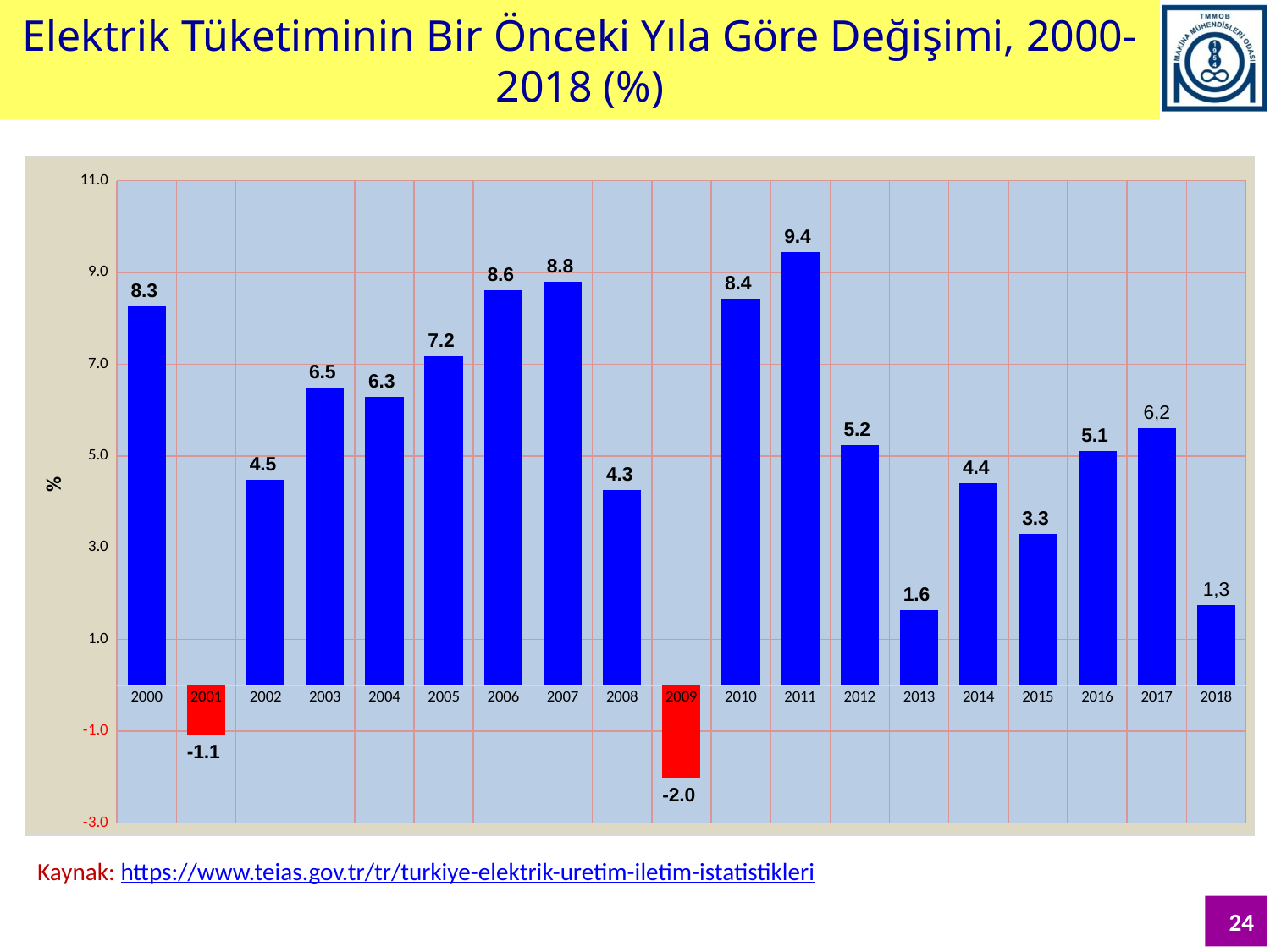
What is the value for 2017? 6,2 What is the value for 2009? -2.0 Which year has the highest value? 2011 What is the difference between the values for 2007 and 2006? 0.2 What is the difference between the values for 2011 and 2010? 1.0 Do the values rise or fall from 2011 to 2013? Fall How many years are shown on the x axis? 19 Which is larger, the value for 2003 or the value for 2004? 2003 What kind of chart is this? Bar chart Which year has the lowest value? 2009 How many bars are coloured red? 2 What is the value for 2011? 9.4